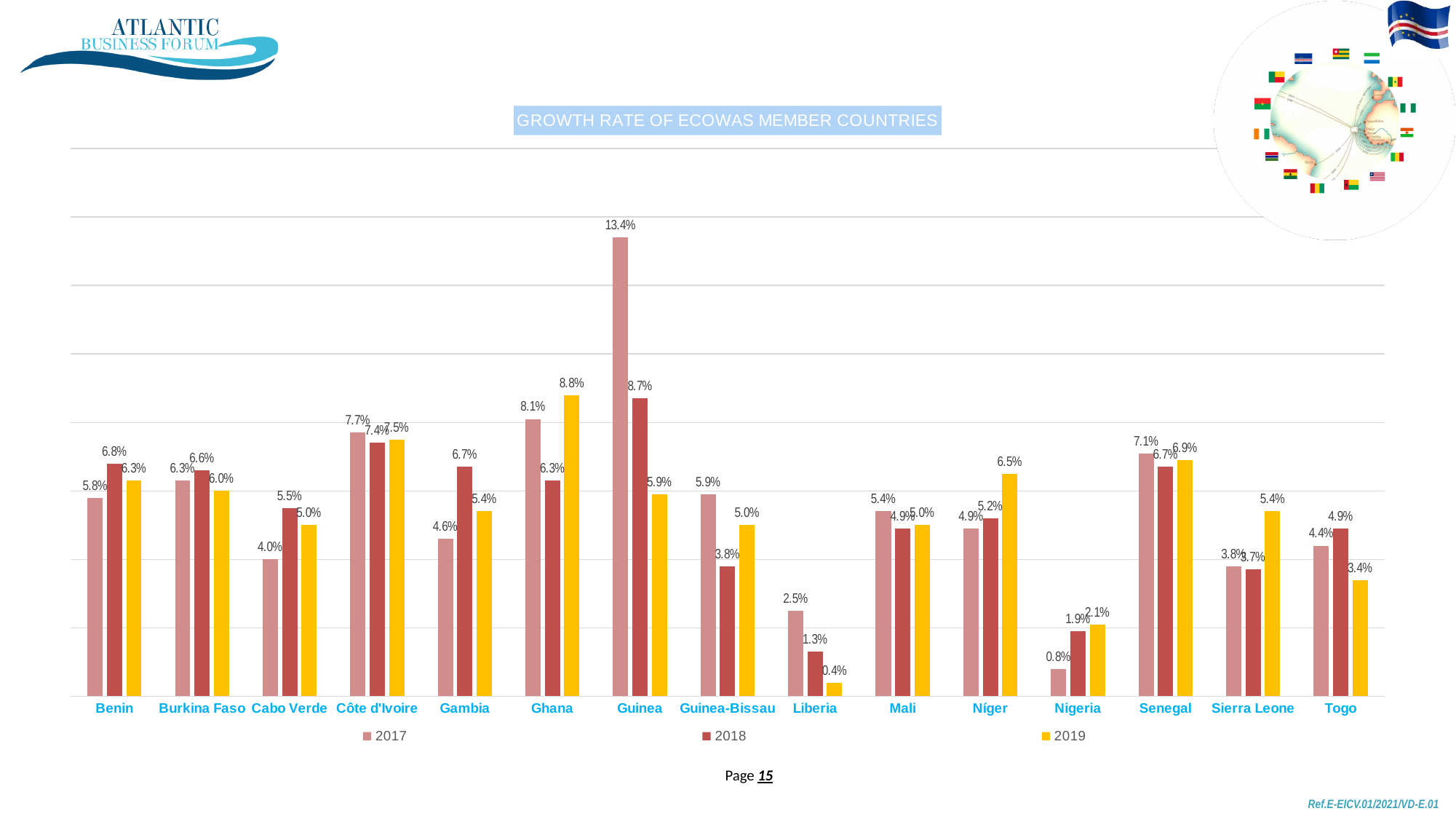
How many series does the legend list? 3 Which country has the lowest 2019 growth rate? Liberia Which country has the lowest 2017 growth rate? Nigeria What is the 2018 growth rate for Liberia? 1.3% Which is larger, Senegal's 2019 growth rate or Níger's 2019 growth rate? Senegal's 2019 growth rate Which country has the highest 2017 growth rate? Guinea What is the difference between Guinea's 2017 and 2018 growth rates? 4.7% What is the 2017 growth rate for Guinea? 13.4% What is the 2019 growth rate for Ghana? 8.8% Do Liberia's growth rates rise or fall from 2017 to 2019? Fall What kind of chart is shown on the slide? Bar chart How many countries are shown on the x axis? 15